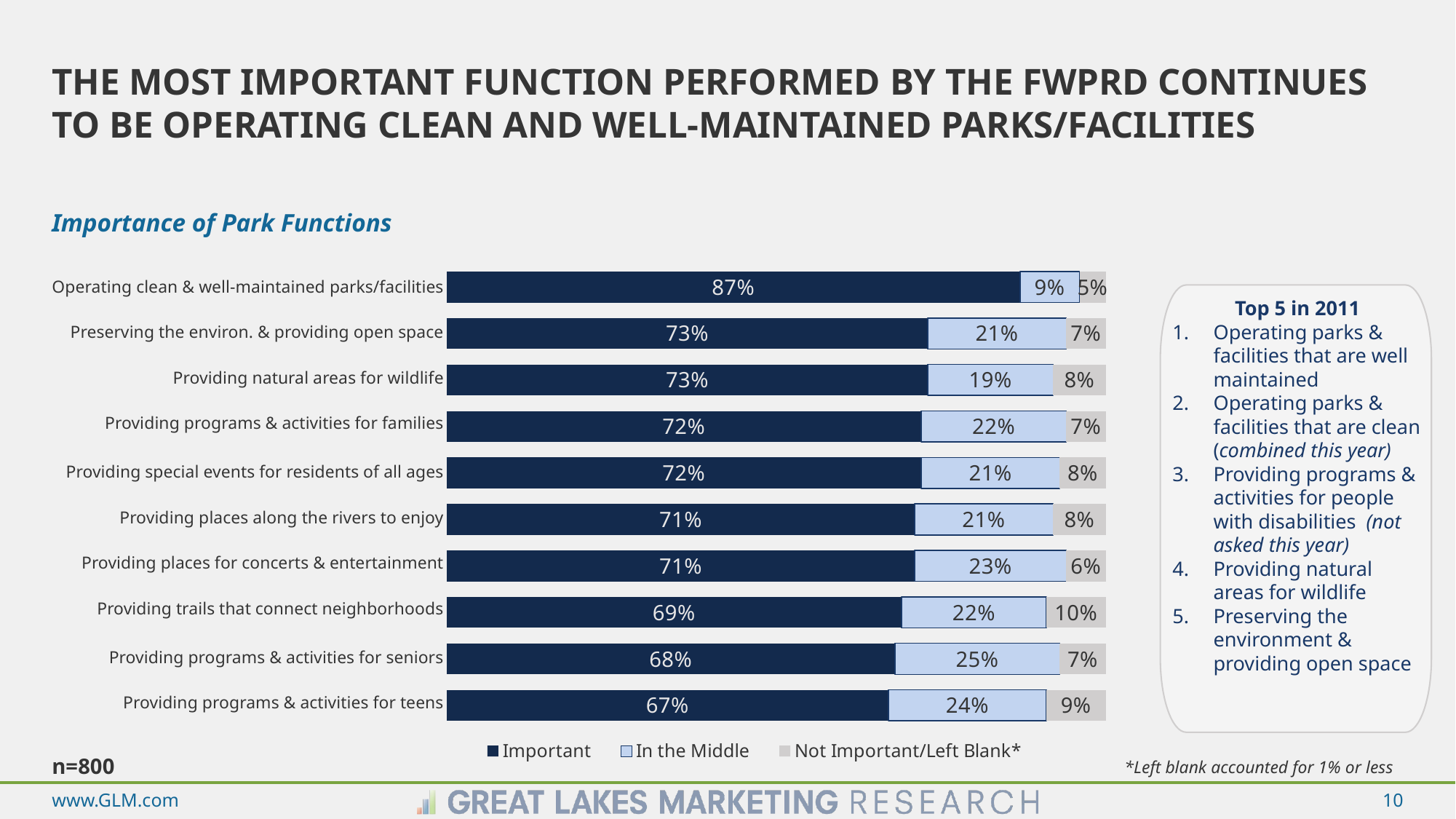
What is the sample size shown for the chart? n=800 What percentage rated operating clean & well-maintained parks/facilities as Important? 87% Which park function has the lowest Important percentage? Providing programs & activities for teens What is the Not Important/Left Blank value for providing trails that connect neighborhoods? 10% How many series does the legend list? 3 Which park function has the highest Not Important/Left Blank percentage? Providing trails that connect neighborhoods What is the In the Middle value for providing programs & activities for seniors? 25% Which park function has the highest Important percentage? Operating clean & well-maintained parks/facilities Which has a larger Important percentage: providing trails that connect neighborhoods or providing programs & activities for seniors? Providing trails that connect neighborhoods How many park functions are shown in the chart? 10 What is the difference in Important percentage between operating clean & well-maintained parks/facilities and preserving the environ. & providing open space? 14 percentage points What type of chart is shown on the slide? Stacked bar chart